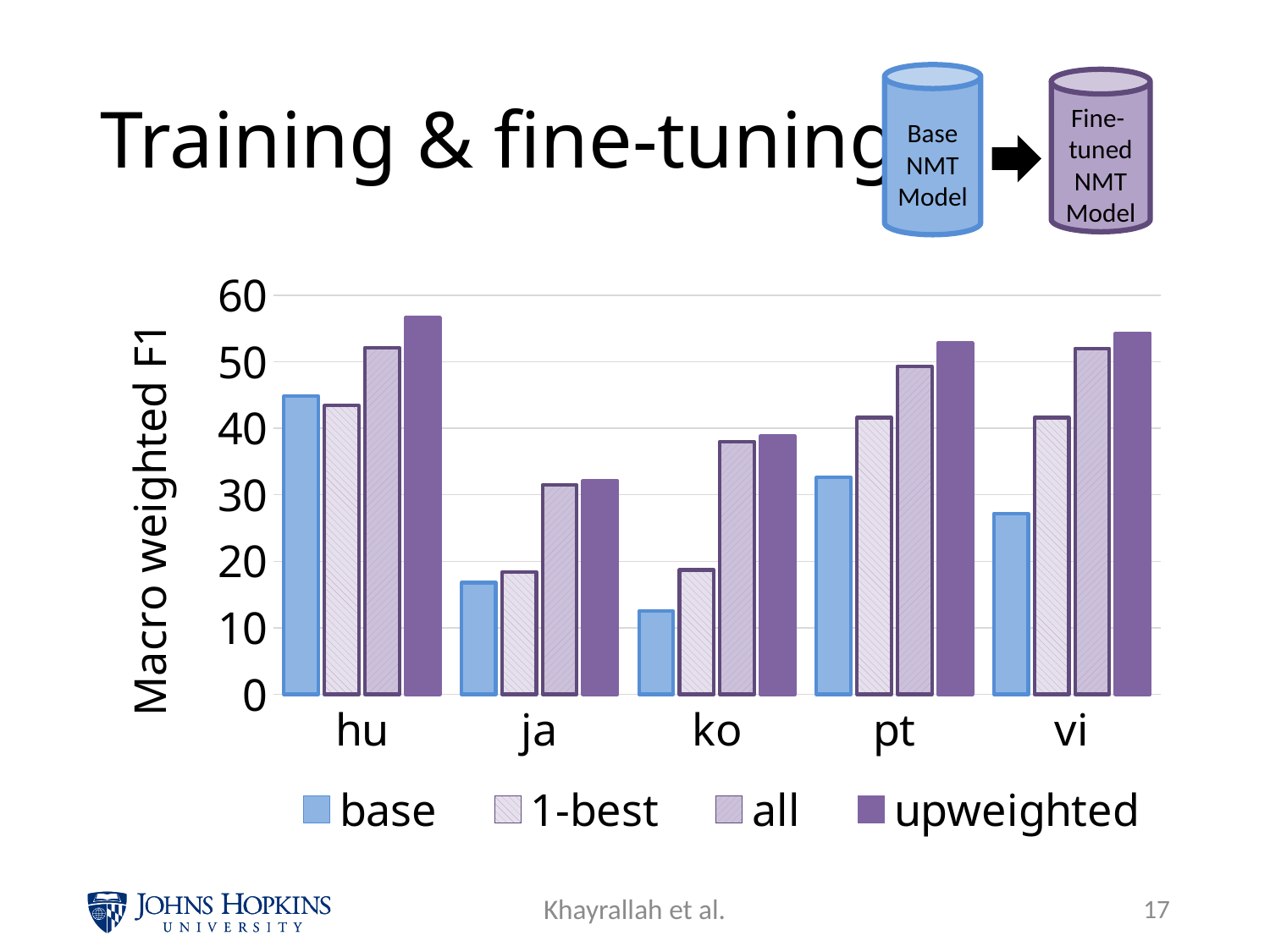
Is the base value for hu greater or less than 40? greater Which language has the highest upweighted bar? hu For pt, which is larger: the base bar or the 1-best bar? 1-best What is the label on the y axis of the chart? Macro weighted F1 What kind of chart is shown on the slide? bar chart Is the upweighted value for ja greater or less than 40? less For hu, which series has the highest bar? upweighted For vi, which is larger: the base bar or the all bar? all Is the base value for ko greater or less than 20? less How many language categories are shown on the x axis? 5 How many series does the legend list? 4 Which language has the lowest base bar? ko